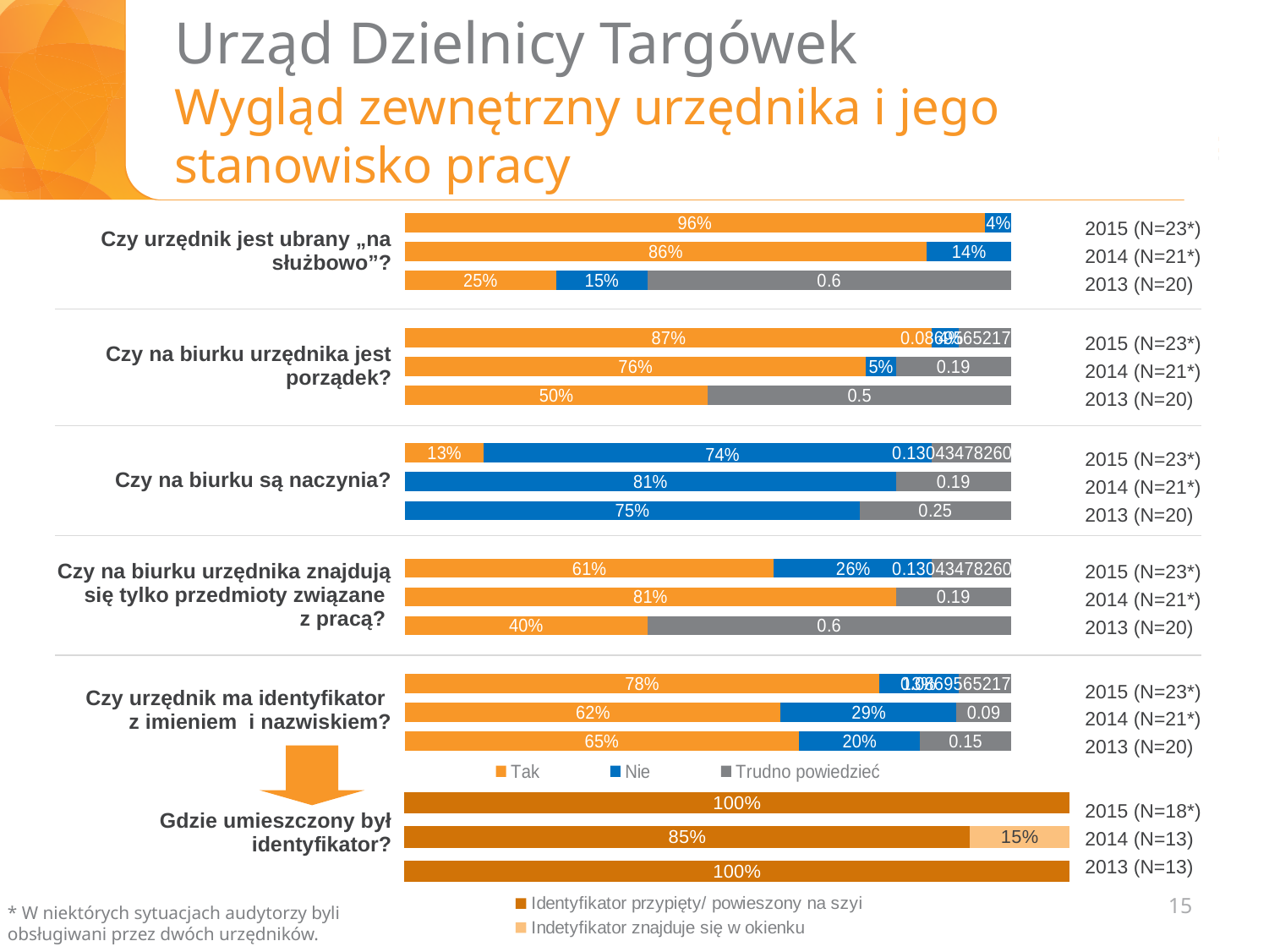
In the chart for "Czy urzędnik jest ubrany „na służbowo”?", what share answered "Nie" in 2014 (N=21*)? 14% How many series does the legend with "Tak", "Nie" and "Trudno powiedzieć" list? 3 In the chart for "Czy urzędnik ma identyfikator z imieniem i nazwiskiem?", which is larger: the "Tak" share in 2014 or in 2013? 2013 In the chart for "Czy na biurku są naczynia?", which year has the highest "Nie" share? 2014 (N=21*) In the chart for "Czy urzędnik jest ubrany „na służbowo”?", what is the difference between the "Tak" share in 2015 and in 2014? 10% In the chart for "Czy urzędnik jest ubrany „na służbowo”?", what share answered "Tak" in 2015 (N=23*)? 96% In the chart for "Czy na biurku urzędnika znajdują się tylko przedmioty związane z pracą?", what share answered "Tak" in 2015 (N=23*)? 61% In the chart for "Czy na biurku są naczynia?", what share answered "Nie" in 2014 (N=21*)? 81% In the chart for "Gdzie umieszczony był identyfikator?", what share in 2014 (N=13) had the identifier in the window ("Indetyfikator znajduje się w okienku")? 15% In the chart for "Czy na biurku urzędnika jest porządek?", what share answered "Nie" in 2014 (N=21*)? 5% In the chart for "Czy na biurku urzędnika jest porządek?", what share answered "Tak" in 2013 (N=20)? 50% What type of chart is used for "Gdzie umieszczony był identyfikator?"? Stacked bar chart